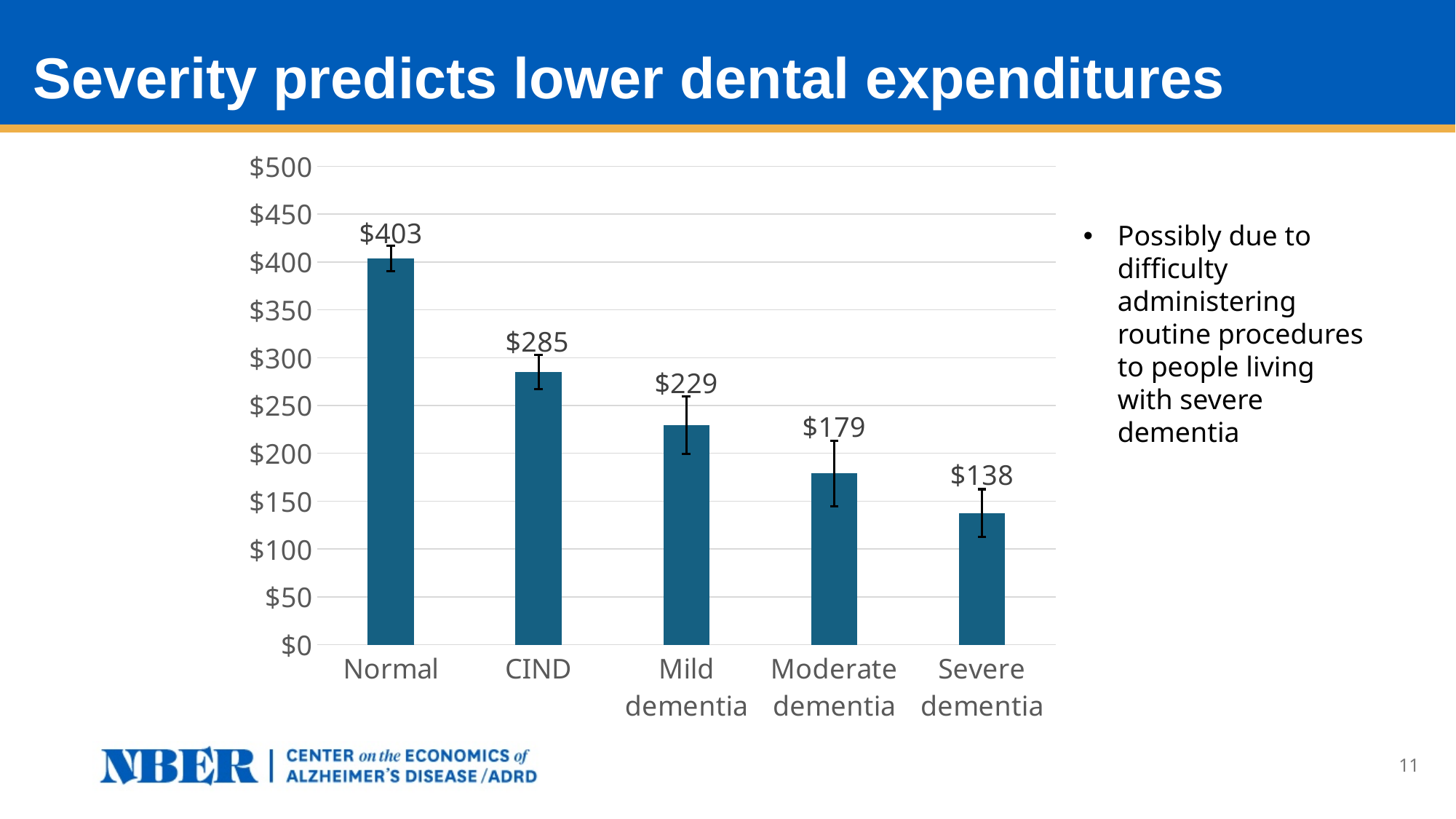
What is the value for Normal? $403 Which is larger, the value for Mild dementia or the value for Moderate dementia? Mild dementia What is the difference between the values for Normal and CIND? $118 What kind of chart is shown on the slide? Bar chart Which category has the lowest value? Severe dementia What is the difference between the values for Moderate dementia and Severe dementia? $41 What is the value for Mild dementia? $229 Which category has the highest value? Normal Do the values rise or fall from left to right along the x axis? Fall How many categories are shown on the x axis? 5 What is the value for CIND? $285 What is the value for Severe dementia? $138